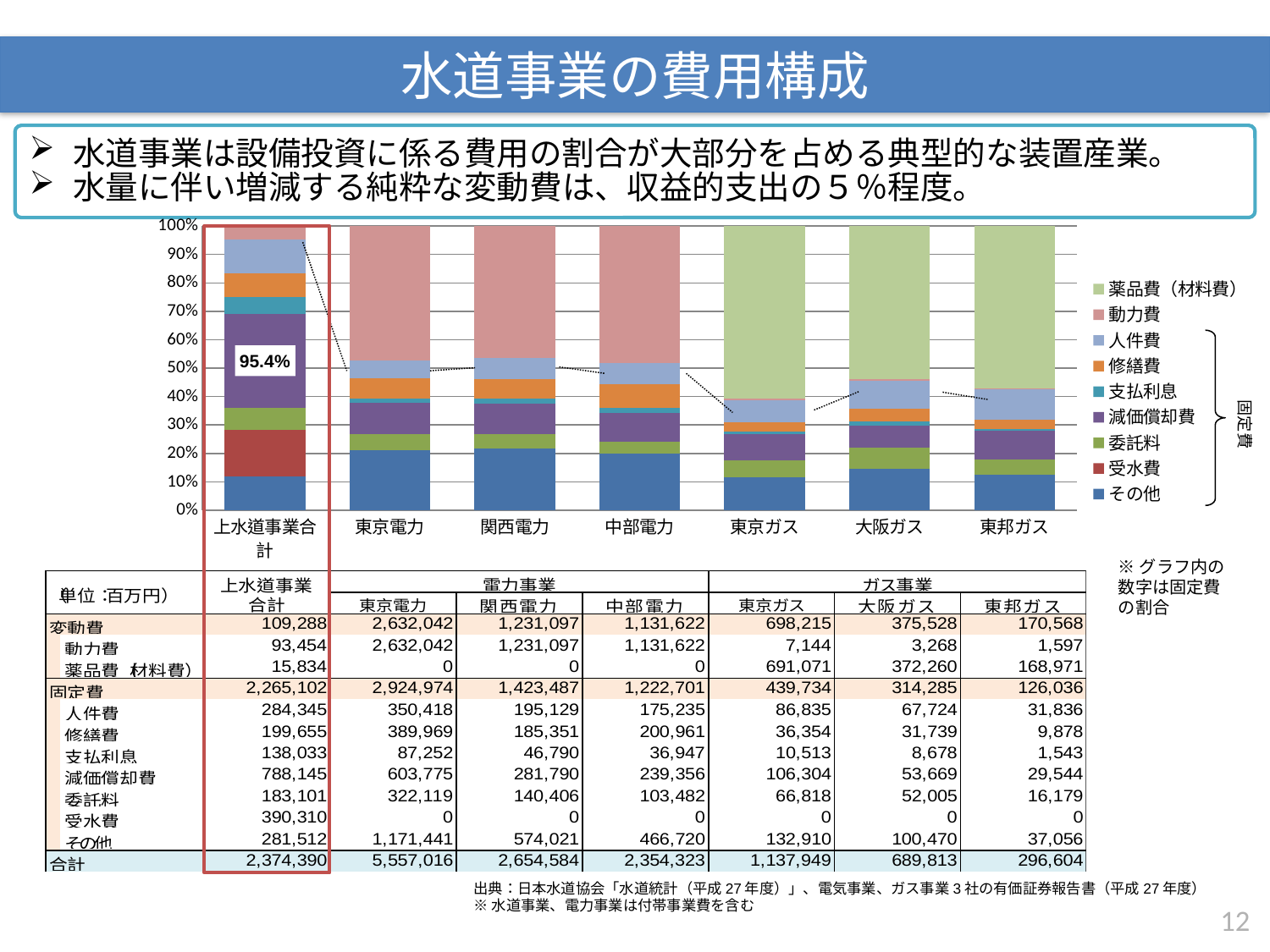
Is the share of 薬品費（材料費） for 東京ガス greater or less than 50%? greater What kind of chart is shown on the slide? stacked bar chart What is the first entry listed in the chart legend? 薬品費（材料費） Which has the larger share of 減価償却費, 上水道事業合計 or 東京電力? 上水道事業合計 Is the share of 動力費 for 東京電力 greater or less than 40%? greater According to the note beside the chart, what does the number printed in the chart represent? 固定費の割合 Is the share of 動力費 for 東京ガス greater or less than 10%? less How many categories are shown on the x axis of the chart? 7 Which category is the only one with a 受水費 segment in the chart? 上水道事業合計 How many series does the chart legend list? 9 What value is printed inside the bar for 上水道事業合計? 95.4%